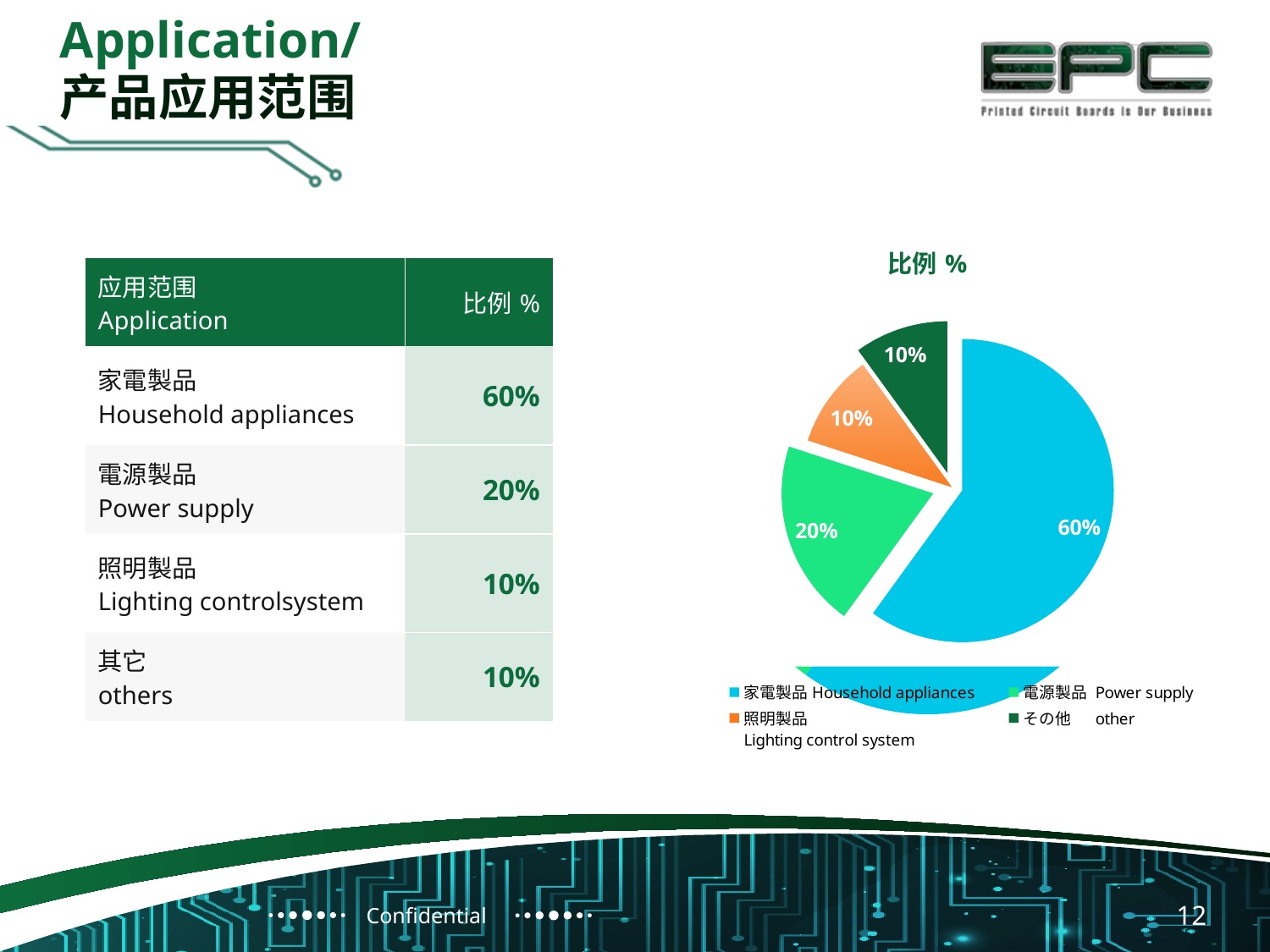
Which category has the largest slice of the pie? Household appliances How many entries does the legend list? 4 What is the difference between the Household appliances share and the Power supply share? 40% What is the title of the pie chart? 比例 % What share of the pie does Power supply (電源製品) have? 20% What share of the pie does other (その他) have? 10% What share of the pie does Lighting control system (照明製品) have? 10% Which is larger, the Power supply slice or the Lighting control system slice? Power supply How many slices does the pie chart have? 4 What share of the pie does Household appliances (家電製品) have? 60% What colour is the Household appliances slice? light blue What type of chart is shown on the slide? pie chart